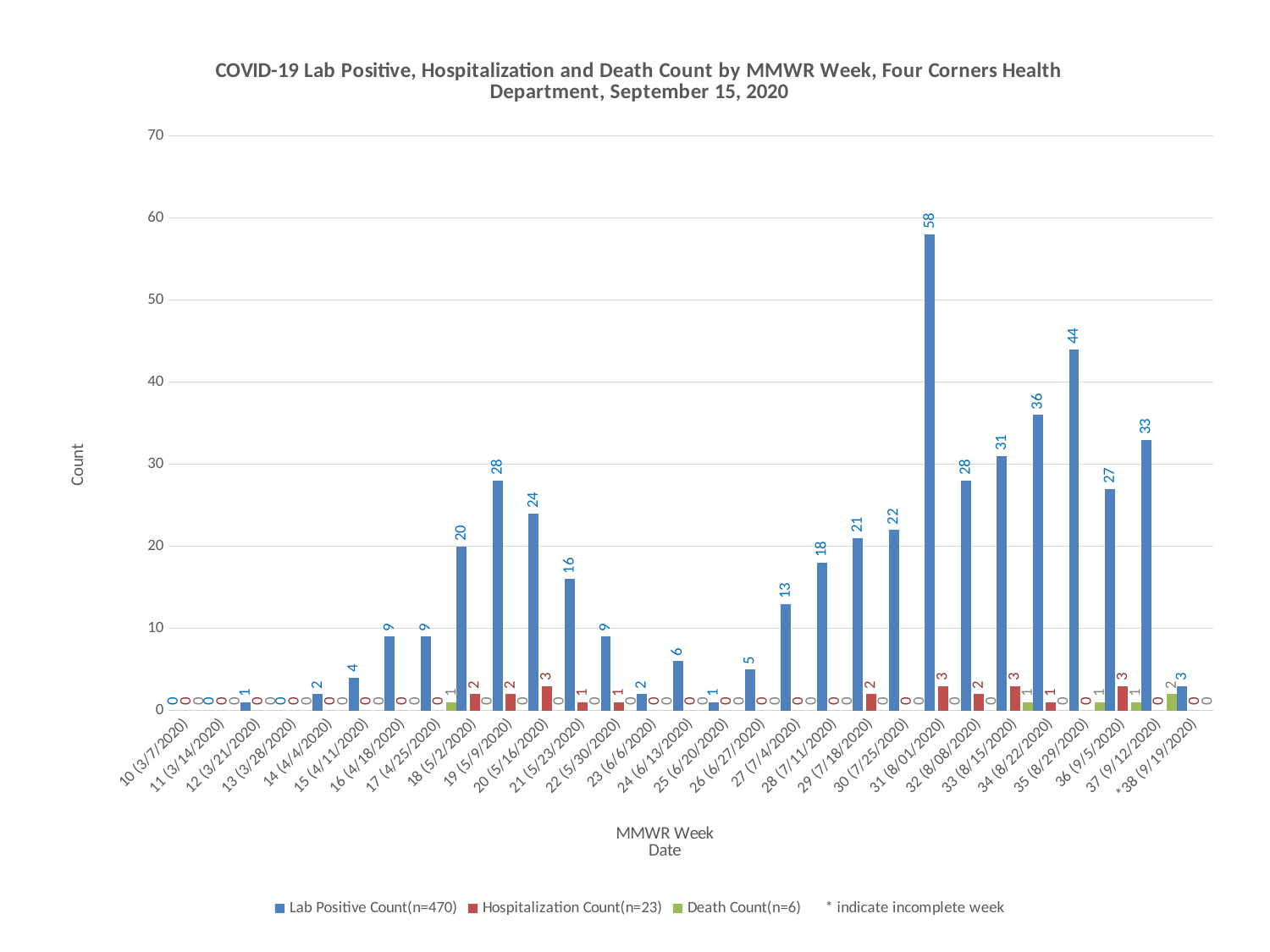
Which has a larger Lab Positive Count, week 19 (5/9/2020) or week 20 (5/16/2020)? 19 (5/9/2020) What kind of chart is shown on the slide? bar chart What is the Lab Positive Count for MMWR week 35 (8/29/2020)? 44 What is the Hospitalization Count for MMWR week 20 (5/16/2020)? 3 Is the Lab Positive Count for week 34 (8/22/2020) greater or less than 30? greater What is the Lab Positive Count for MMWR week 31 (8/01/2020)? 58 What is the difference between the Lab Positive Count for week 31 (8/01/2020) and week 35 (8/29/2020)? 14 Do the Lab Positive Counts rise or fall from week 31 (8/01/2020) to week 32 (8/08/2020)? fall Which MMWR week has the highest Lab Positive Count? 31 (8/01/2020) How many series does the legend list? 3 What is the Death Count for MMWR week 17 (4/25/2020)? 1 According to the legend, what is the total n for the Hospitalization Count series? 23